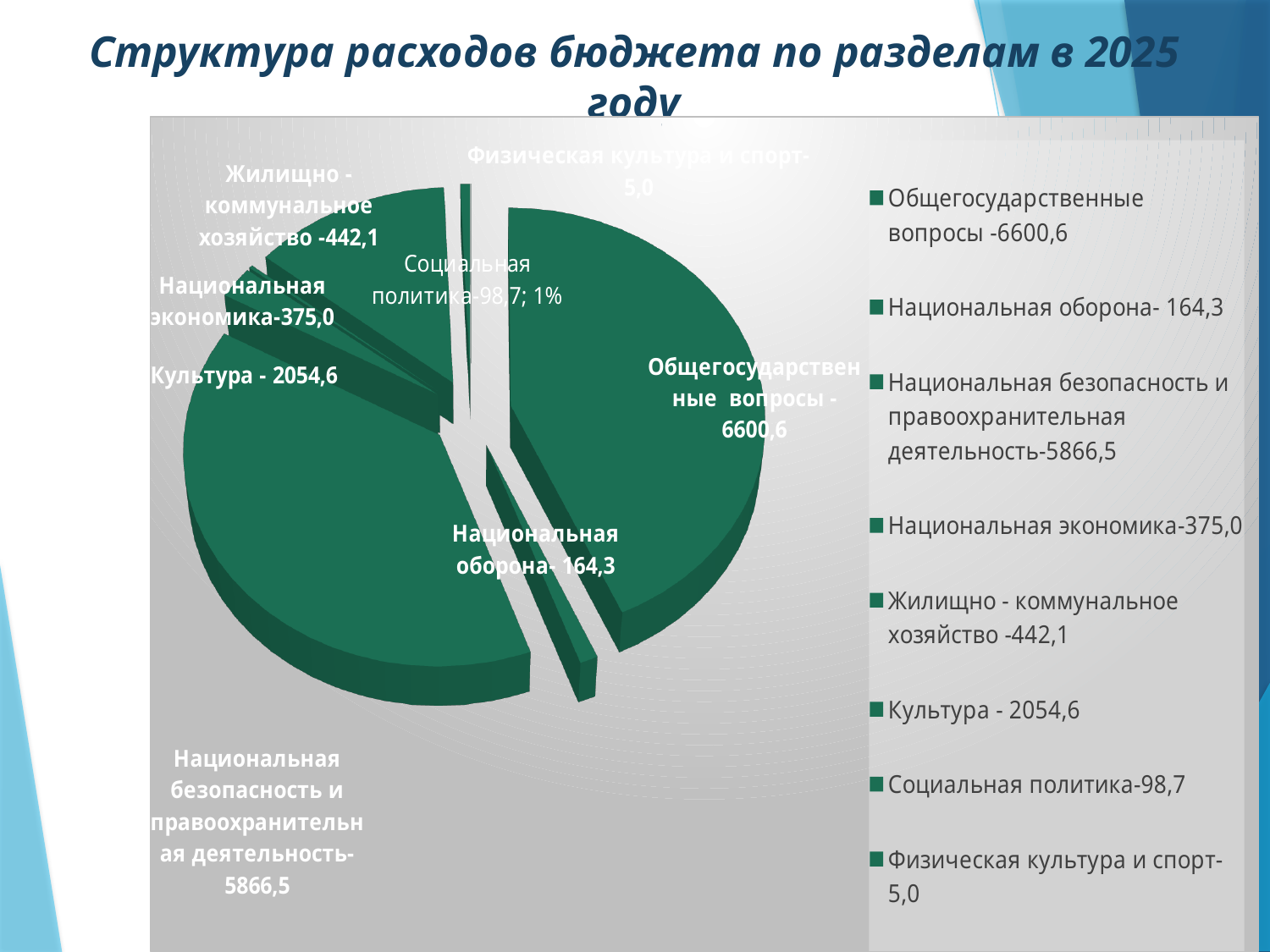
Which is larger: the value for Жилищно - коммунальное хозяйство or the value for Национальная экономика? Жилищно - коммунальное хозяйство What is the value for Культура? 2054,6 What is the difference between the values for Общегосударственные вопросы and Национальная безопасность и правоохранительная деятельность? 734,1 What is the value for Общегосударственные вопросы? 6600,6 What is the title of the chart slide? Структура расходов бюджета по разделам в 2025 году How many categories does the legend of the pie chart list? 8 Which category has the smallest value in the pie chart? Физическая культура и спорт What is the value for Жилищно - коммунальное хозяйство? 442,1 What is the value for Национальная оборона? 164,3 Which category has the largest value in the pie chart? Общегосударственные вопросы What kind of chart is shown on the slide? Pie chart What percentage share of the pie is shown for Социальная политика? 1%